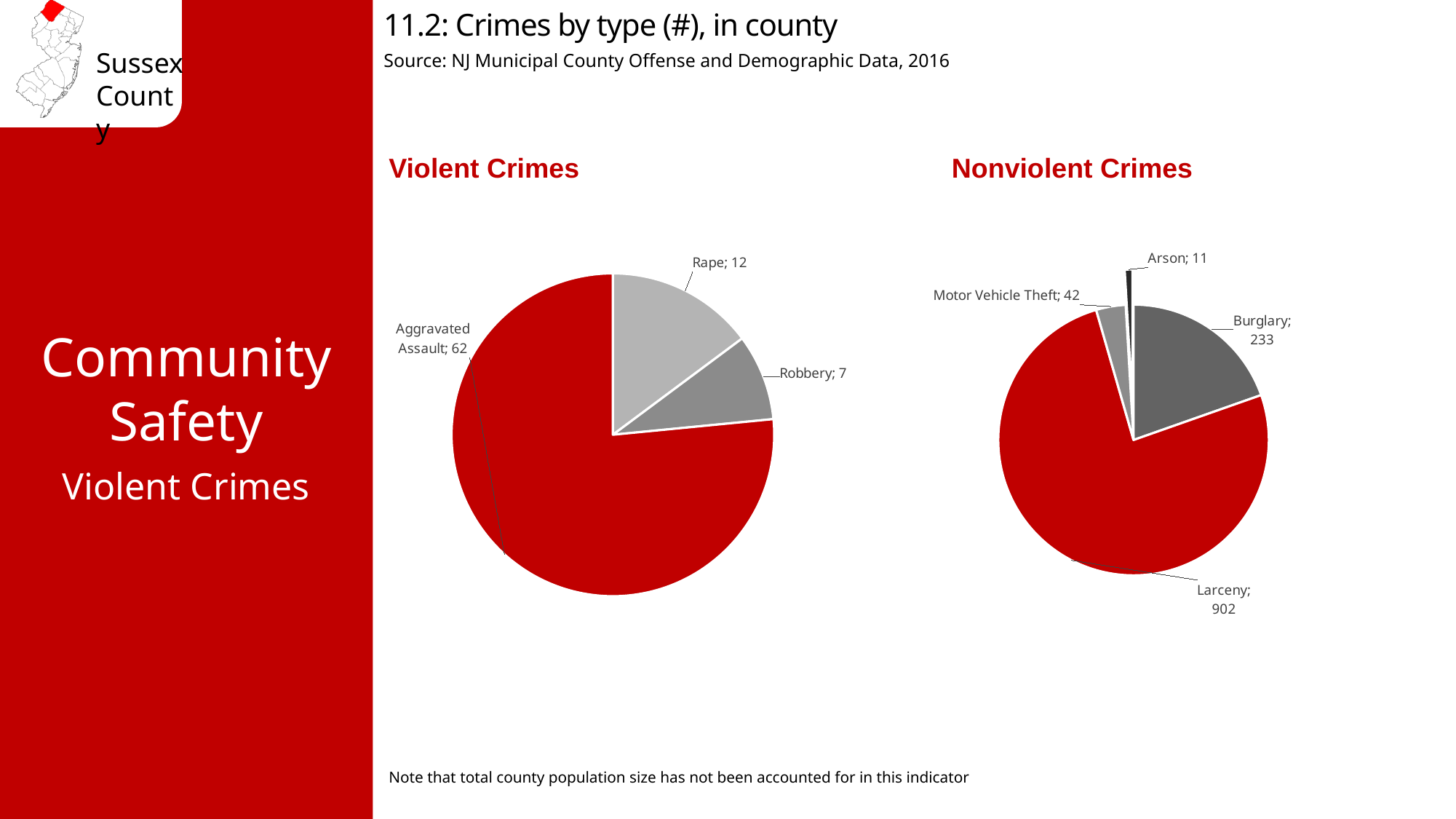
In the Nonviolent Crimes pie chart, what is the difference between Larceny and Burglary? 669 What is the total of all values in the Violent Crimes pie chart? 81 In the Violent Crimes pie chart, what is the value for Robbery? 7 In the Violent Crimes pie chart, how many aggravated assaults are shown? 62 In the Nonviolent Crimes pie chart, what is the value for Burglary? 233 How many slices does the Nonviolent Crimes pie chart have? 4 In the Violent Crimes pie chart, which crime type has the largest slice? Aggravated Assault In the Nonviolent Crimes pie chart, which crime type has the smallest slice? Arson In the Violent Crimes pie chart, what is the difference between Rape and Robbery? 5 What type of chart is used for Violent Crimes? Pie chart In the Nonviolent Crimes pie chart, what is the value for Motor Vehicle Theft? 42 In the Nonviolent Crimes pie chart, which is larger, Motor Vehicle Theft or Arson? Motor Vehicle Theft